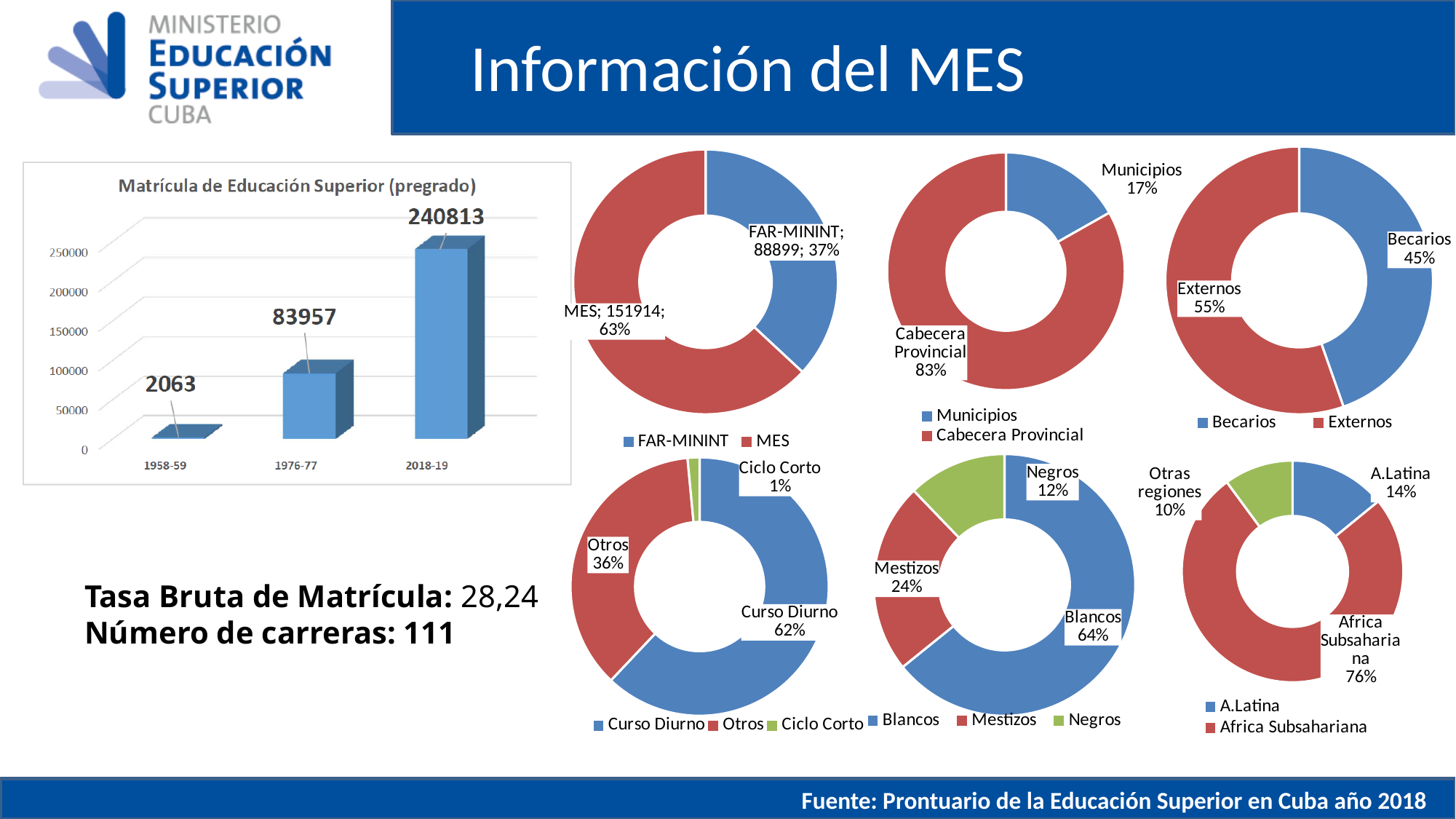
In the doughnut chart with the Blancos, Mestizos and Negros legend, what is the difference between the Blancos and Mestizos shares? 40% In the bar chart 'Matrícula de Educación Superior (pregrado)', how many periods are shown on the x axis? 3 In the bar chart 'Matrícula de Educación Superior (pregrado)', what is the difference between the 2018-19 and 1976-77 values? 156856 What kind of chart is 'Matrícula de Educación Superior (pregrado)'? bar chart In the doughnut chart with the FAR-MININT and MES legend, what value is shown for MES? 151914; 63% In the doughnut chart with the Municipios and Cabecera Provincial legend, what share does Cabecera Provincial have? 83% In the bar chart 'Matrícula de Educación Superior (pregrado)', do the values rise or fall from 1958-59 to 2018-19? rise In the bar chart 'Matrícula de Educación Superior (pregrado)', what is the value for 2018-19? 240813 How many entries does the legend of the doughnut chart with A.Latina and Africa Subsahariana list? 2 In the doughnut chart with the Becarios and Externos legend, which segment is larger, Becarios or Externos? Externos In the doughnut chart with the Curso Diurno, Otros and Ciclo Corto legend, what share does Ciclo Corto have? 1% In the bar chart 'Matrícula de Educación Superior (pregrado)', which period has the lowest value? 1958-59